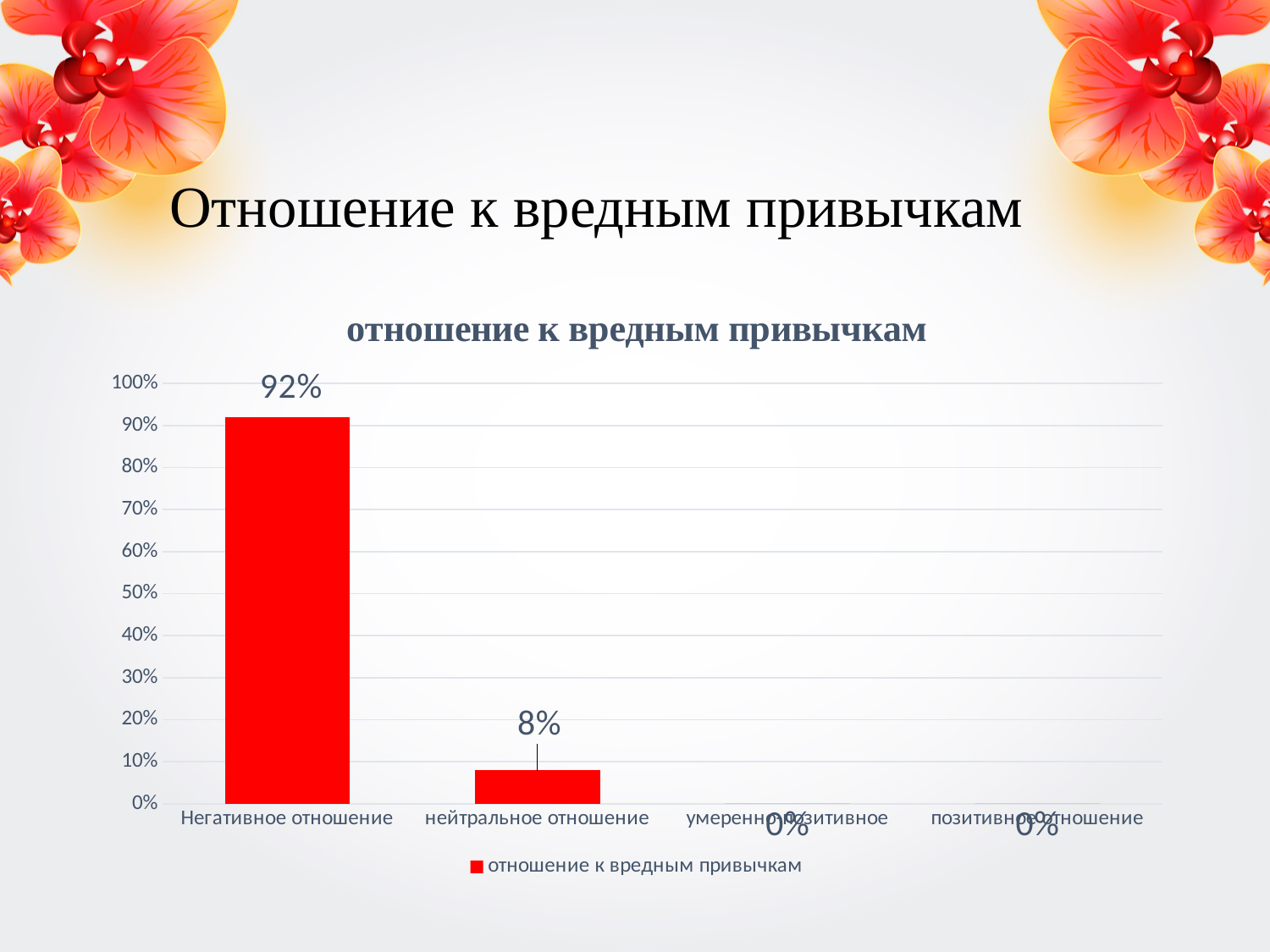
What is the difference between the values for "Негативное отношение" and "нейтральное отношение"? 84% What is the title of the chart? отношение к вредным привычкам How many series does the legend list? 1 Which category has the highest value? Негативное отношение Is the value for "Негативное отношение" greater or less than 50%? greater Which is larger, the value for "Негативное отношение" or the value for "нейтральное отношение"? Негативное отношение How many categories are shown on the x axis? 4 What value is shown for "позитивное отношение"? 0% What value is shown for "нейтральное отношение"? 8% What value is shown for "Негативное отношение"? 92% What kind of chart is shown on the slide? bar chart Is the value for "нейтральное отношение" greater or less than 10%? less